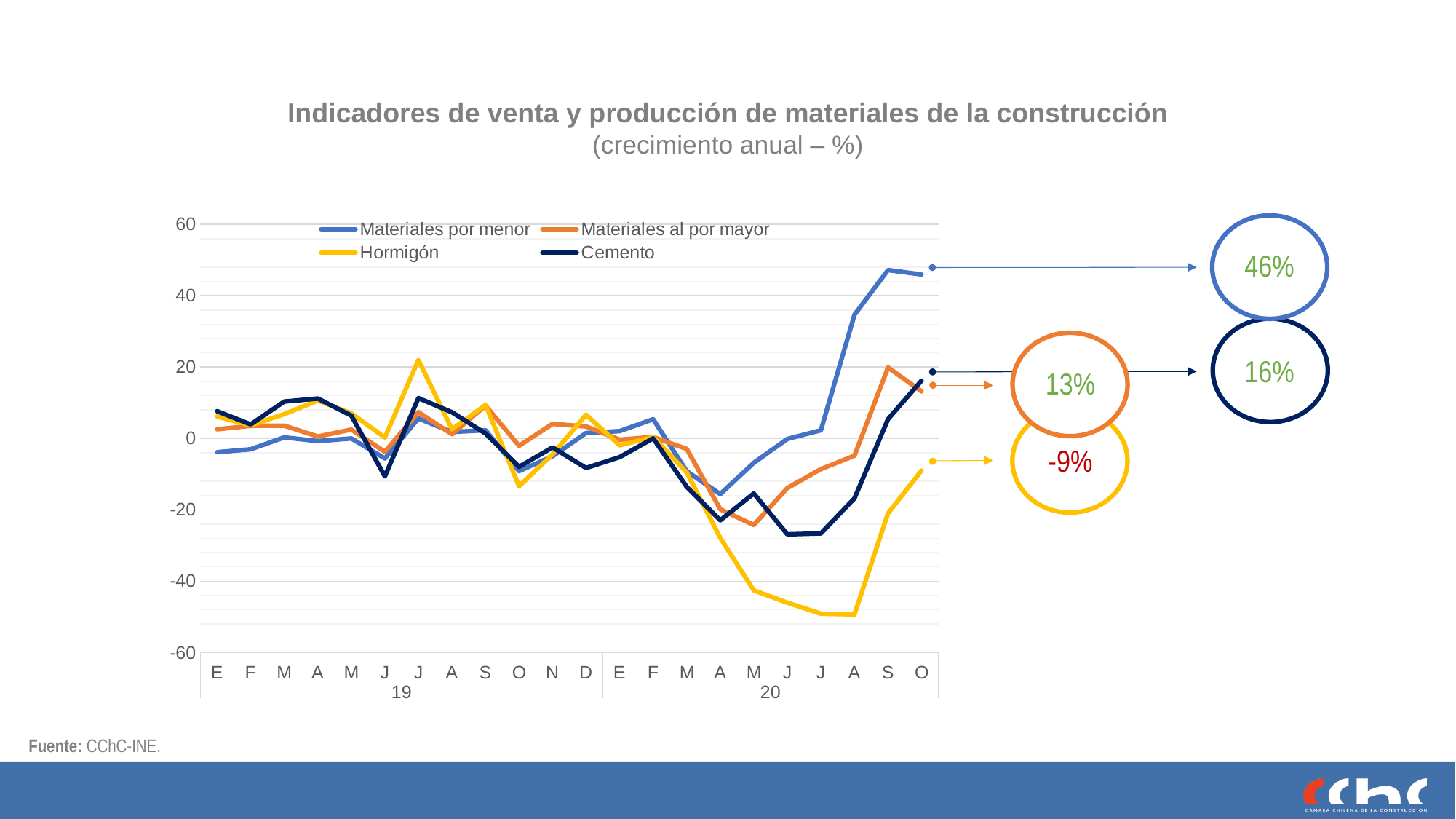
Which series has the lowest value at the last point (O 20)? Hormigón What is the difference between the latest values of Materiales por menor (46%) and Cemento (16%)? 30 percentage points At the last point, which is larger: Cemento or Materiales al por mayor? Cemento What kind of chart is shown on the slide? line chart What is the latest value shown for Cemento? 16% What is the title of the chart? Indicadores de venta y producción de materiales de la construcción (crecimiento anual – %) Is the value for Hormigón in J (July) 20 greater or less than -40? less What is the latest value shown for Materiales por menor? 46% Which series has the highest value at the last point (O 20)? Materiales por menor What is the latest value shown for Materiales al por mayor? 13% How many series does the legend list? 4 What is the latest value shown for Hormigón? -9%